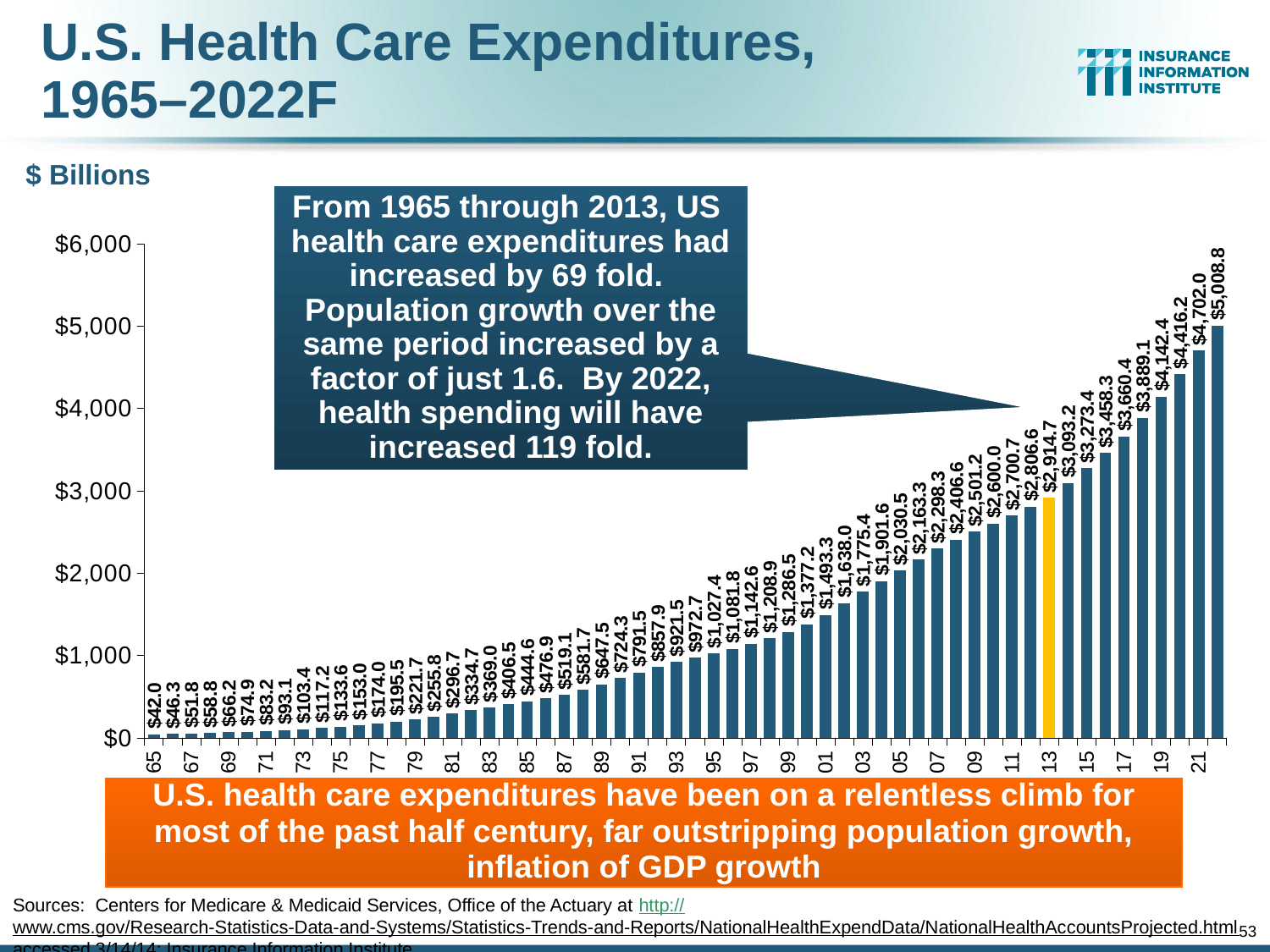
Which year has the highest health care expenditure value? 2022 What is the value shown for 1995? $1,027.4 What is the value shown for 2005? $2,030.5 Do the values generally rise or fall from 1965 to 2022? rise What is the value of U.S. health care expenditures for 1965? $42.0 What is the difference between the 2022F value and the 1965 value? $4,966.8 Which is larger, the value for 1985 or the value for 2005? 2005 Which year has the lowest health care expenditure value? 1965 What is the value shown for the final bar, 2022F? $5,008.8 What type of chart is shown on the slide? bar chart What unit is stated for the values on the chart? $ Billions What is the value shown for 2013, the highlighted bar? $2,914.7